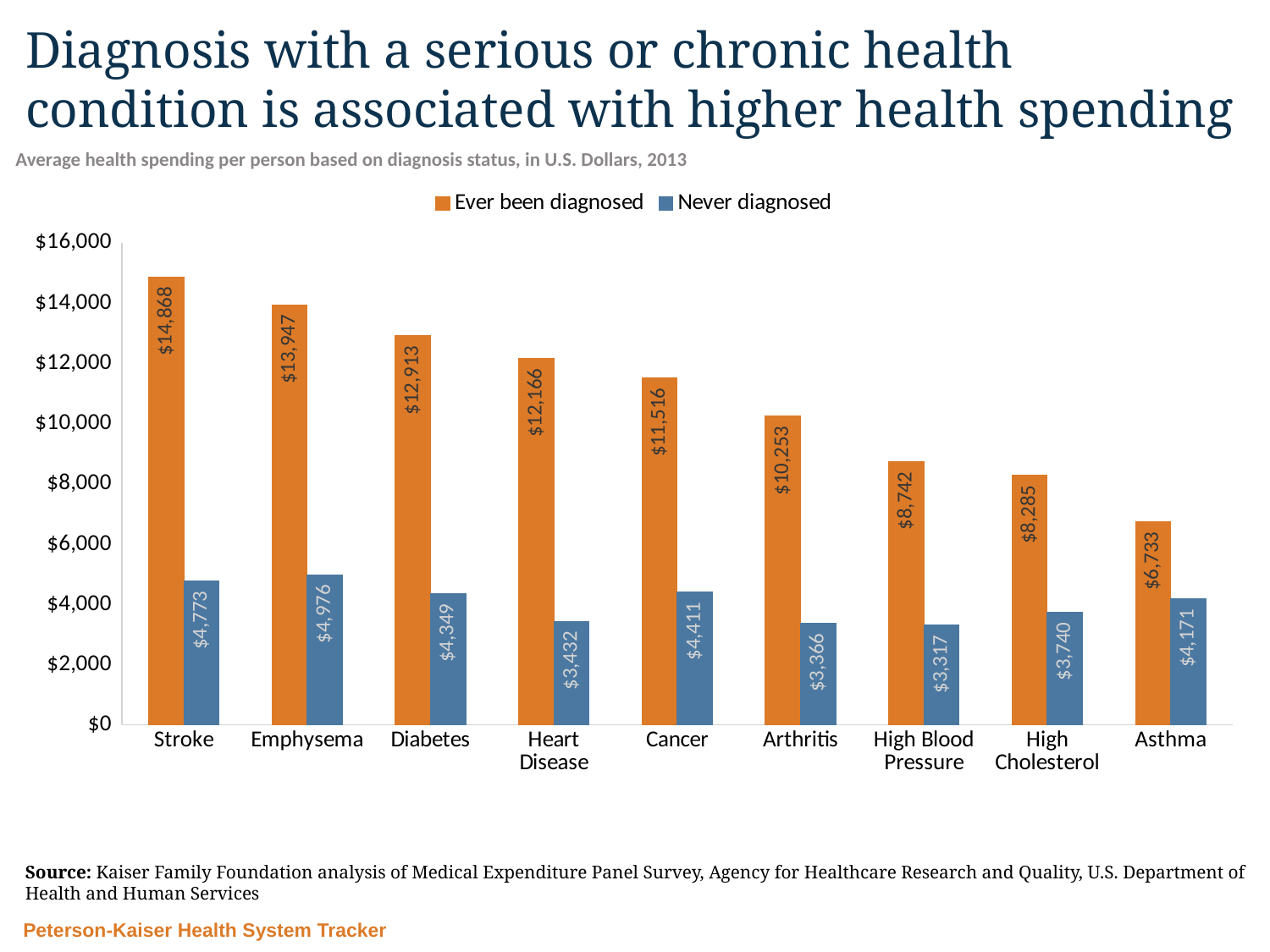
What is the average health spending for people who have ever been diagnosed with stroke? $14,868 What is the value for 'Ever been diagnosed' for asthma? $6,733 Do the 'Ever been diagnosed' values rise or fall from left to right across the conditions? Fall How many series does the legend list? 2 Which condition has the highest 'Ever been diagnosed' spending? Stroke What is the average health spending for people never diagnosed with emphysema? $4,976 Which is larger: 'Never diagnosed' spending for diabetes or for heart disease? Diabetes Which condition has the lowest 'Never diagnosed' spending? High Blood Pressure What is the difference between 'Ever been diagnosed' and 'Never diagnosed' spending for cancer? $7,105 Is the 'Ever been diagnosed' value for arthritis greater or less than $10,000? greater What kind of chart is shown on the slide? Bar chart How many health conditions are shown on the x axis? 9